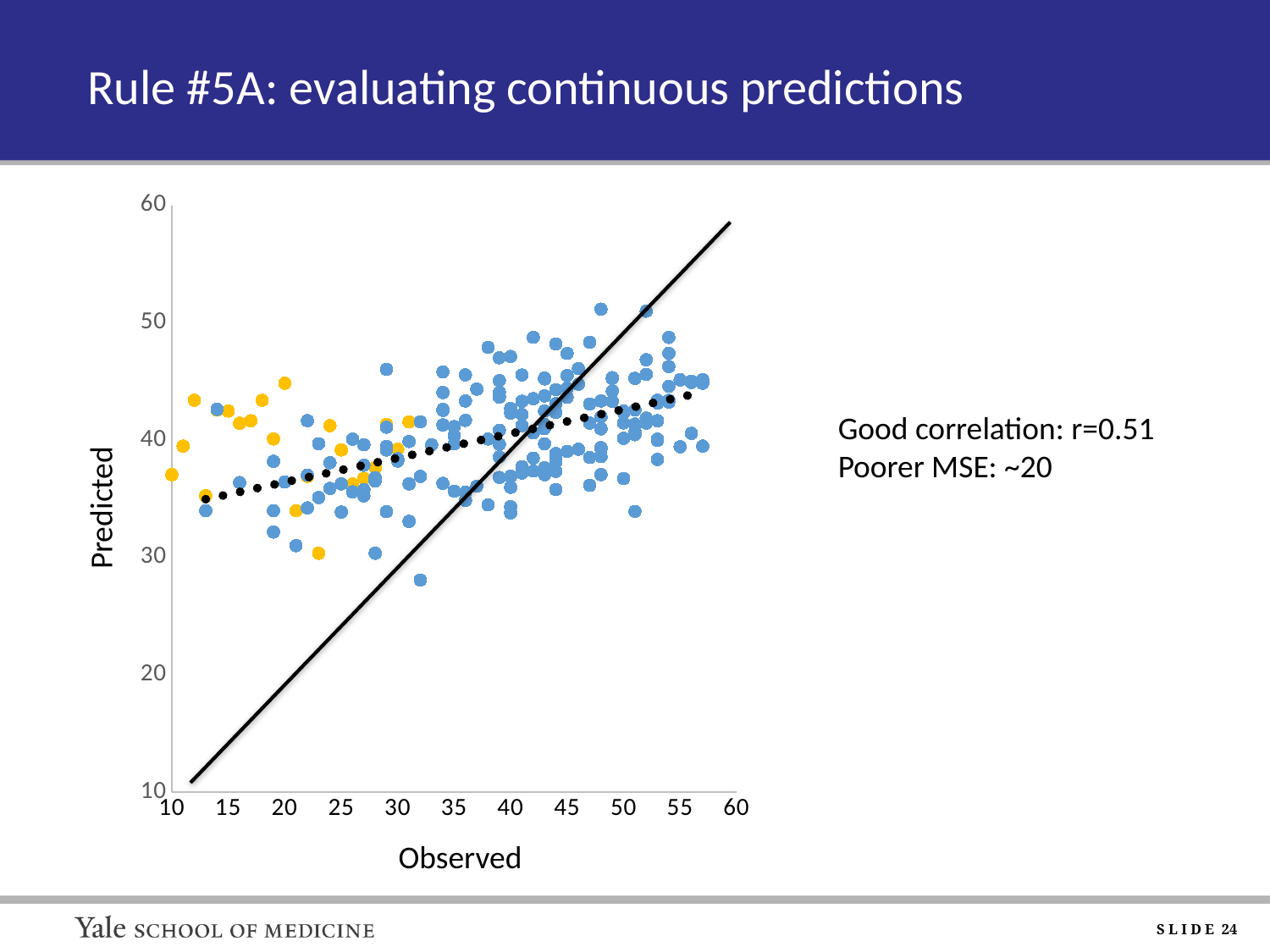
Is the Predicted value of the highest blue point (near Observed 48) greater or less than 50? greater What is the highest value shown on the y axis of the chart? 60 What is the lowest value shown on the x axis of the chart? 10 What correlation coefficient is stated next to the chart? r=0.51 Does the dotted trend line through the points rise or fall as Observed increases? Rises What is the interval between consecutive tick labels on the y axis? 10 What is the interval between consecutive tick labels on the x axis? 5 Is the Predicted value of the lowest blue point (near Observed 32) greater or less than 30? less Are the orange points mostly located at Observed values less than or greater than 35? less What is the title of the x axis of the chart? Observed What kind of chart is shown on the slide? Scatter plot What is the title of the y axis of the chart? Predicted